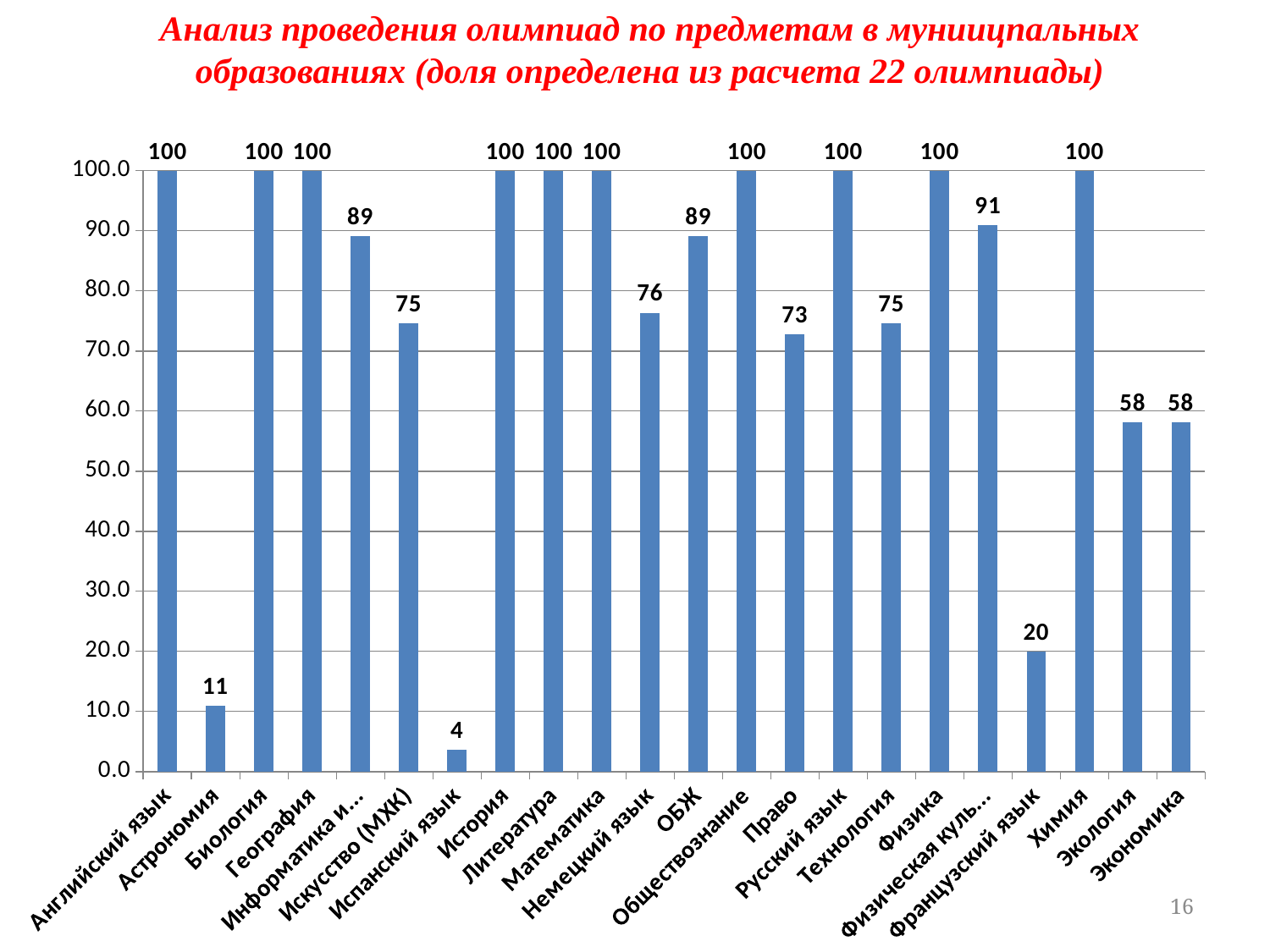
Which is larger, the value for Технология or the value for Право? Технология What is the value for Астрономия? 11 How many subject categories are plotted on the chart? 22 What type of chart is shown on the slide? bar chart What is the value for Право? 73 Is the value for Экология greater or less than 50? greater What is the value for Немецкий язык? 76 Which subject has the lowest value? Испанский язык What is the value for Французский язык? 20 How many subjects have a value of 100? 10 What is the difference between the values for Астрономия and Испанский язык? 7 What is the difference between the values for ОБЖ and Немецкий язык? 13